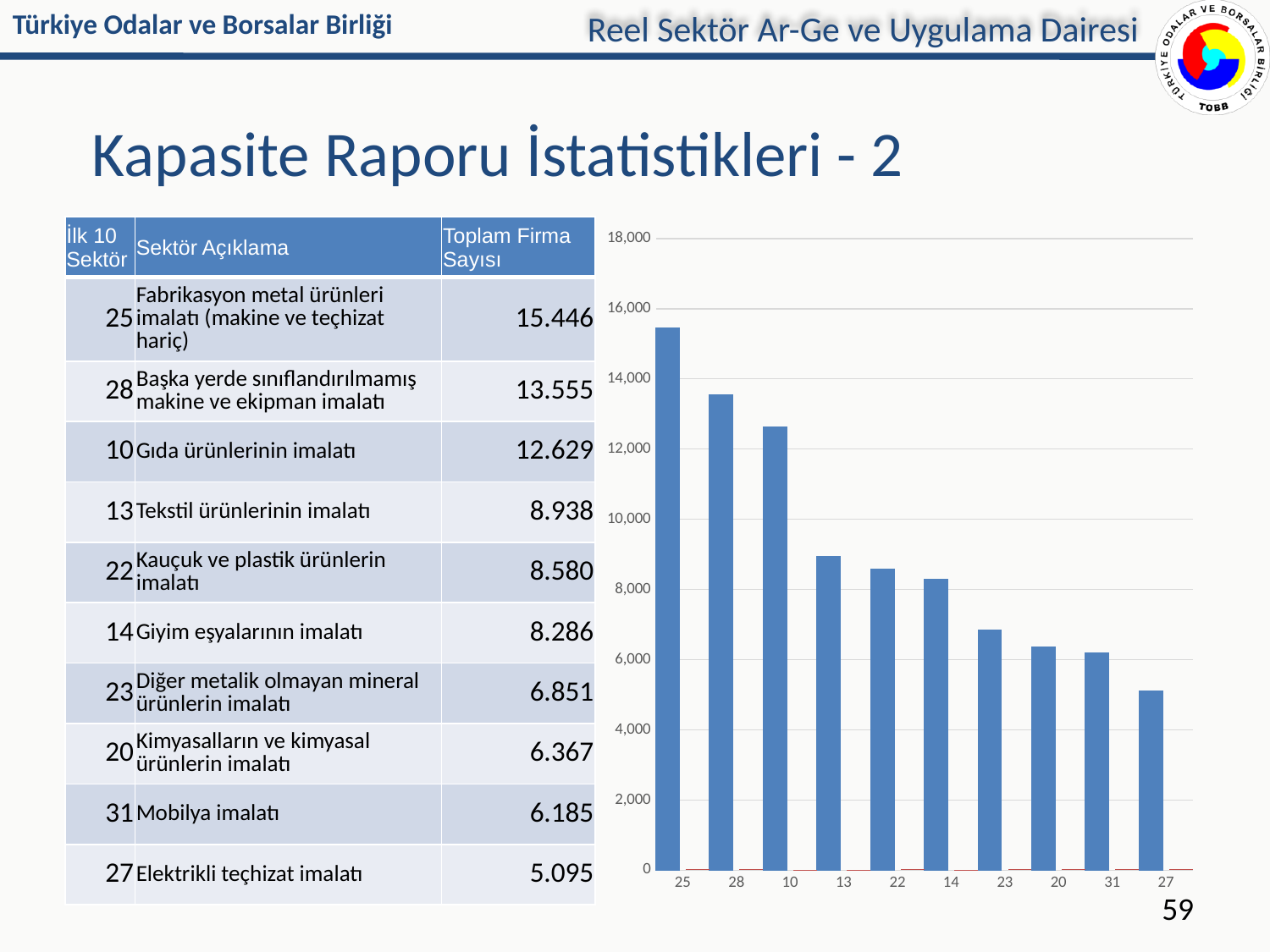
What is the highest value shown on the chart's vertical axis? 18,000 Which is larger in the chart, the bar for sector 13 or the bar for sector 20? 13 According to the table, what is the Toplam Firma Sayısı for sector 31 (Mobilya imalatı)? 6.185 Which sector code has the highest bar in the chart? 25 Is the bar for sector 23 greater or less than 8,000? less Using the table values, what is the difference between the Toplam Firma Sayısı of sector 25 and sector 28? 1.891 Do the bar values rise or fall from left to right along the x axis? fall How many bars (sector codes) are plotted in the chart? 10 Is the bar for sector 28 greater or less than 12,000? greater What kind of chart is shown on the slide? bar chart Which sector code has the lowest bar in the chart? 27 According to the table, what is the Toplam Firma Sayısı for sector 10 (Gıda ürünlerinin imalatı)? 12.629